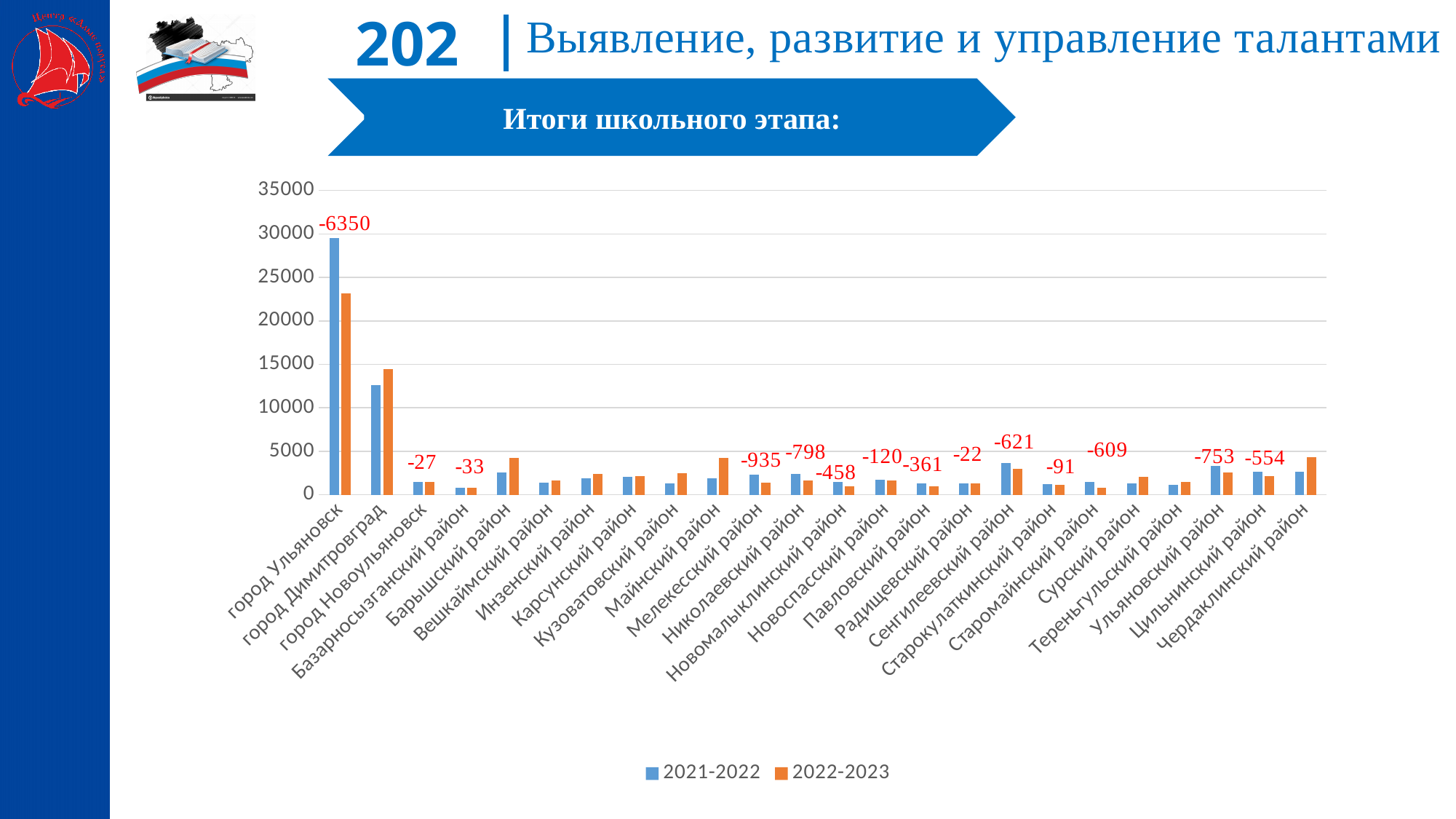
How many municipalities (categories) are shown on the x axis? 24 Is the 2021-2022 value for город Димитровград greater or less than 10000? greater What red annotation is printed above the bars for город Ульяновск? -6350 Which category has the highest value for the 2021-2022 series? город Ульяновск Is the 2021-2022 value for город Ульяновск greater or less than 25000? greater How many series does the legend list? 2 For город Димитровград, which series has the larger value, 2021-2022 or 2022-2023? 2022-2023 Is the 2022-2023 value for город Ульяновск greater or less than 25000? less Which category has the highest value for the 2022-2023 series? город Ульяновск For город Ульяновск, which series has the larger value, 2021-2022 or 2022-2023? 2021-2022 Which colour represents the 2022-2023 series in the legend? orange What kind of chart is shown on the slide? bar chart